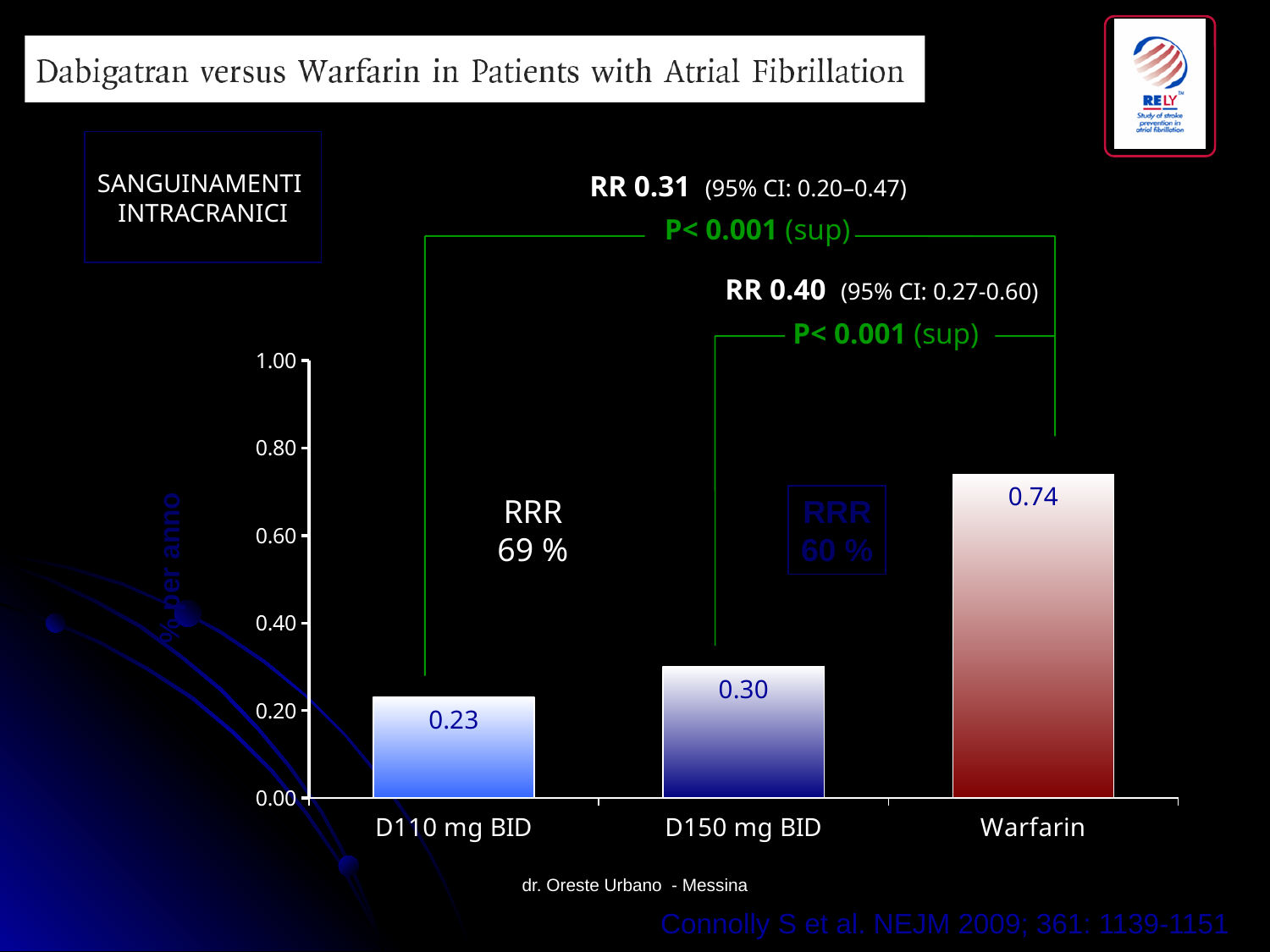
What is the value for D150 mg BID? 0.30 What is the label of the y axis? % per anno Which is larger, the value for D150 mg BID or the value for Warfarin? Warfarin What is the value for Warfarin? 0.74 How many categories are shown on the x axis? 3 What is the difference between the values for D150 mg BID and D110 mg BID? 0.07 Is the value for Warfarin greater or less than 0.60? greater Which category has the lowest value? D110 mg BID What is the difference between the values for Warfarin and D110 mg BID? 0.51 What is the value for D110 mg BID? 0.23 What kind of chart is shown on the slide? bar chart Which category has the highest value? Warfarin